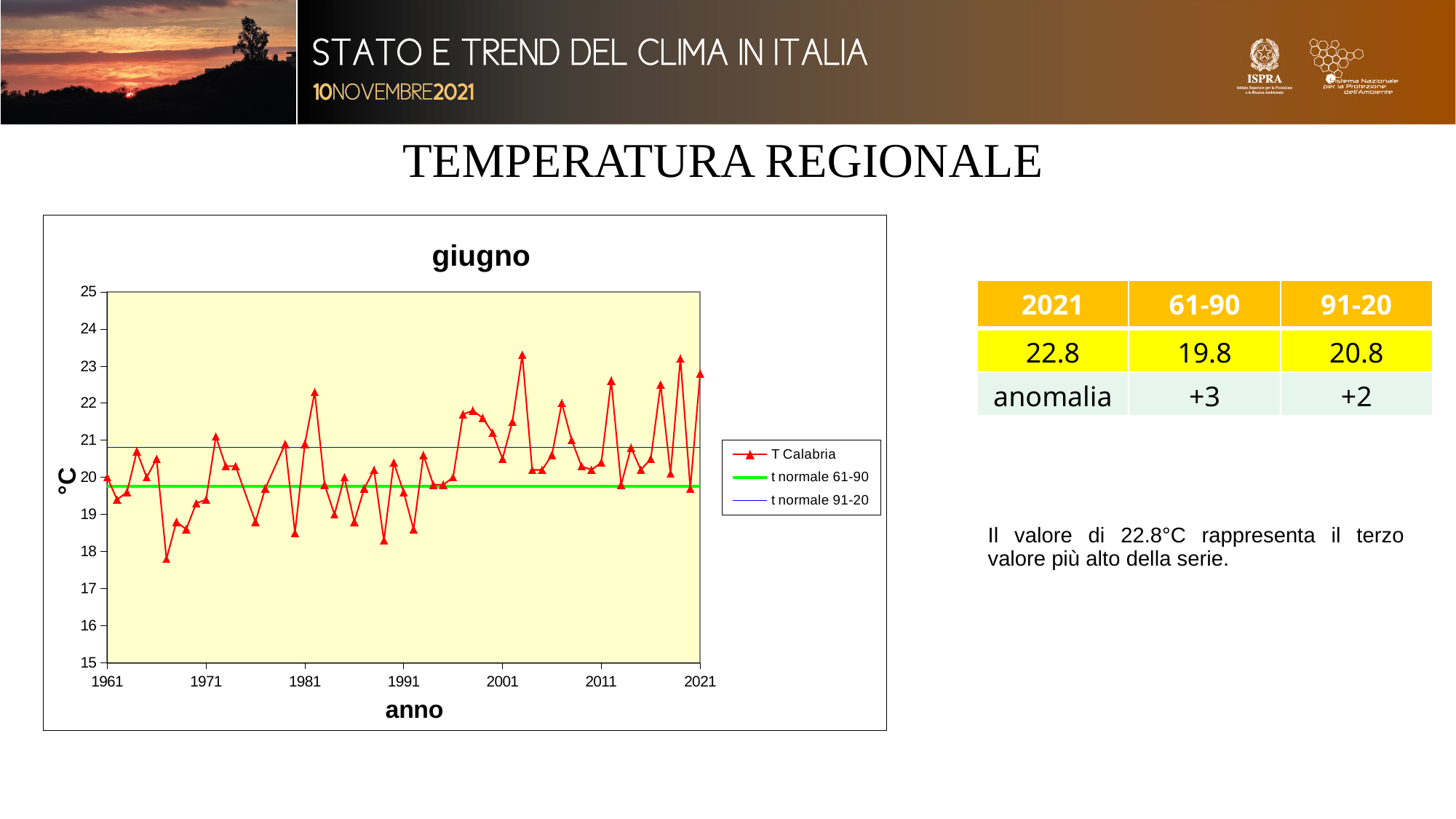
What is the title of the chart? giugno Do the T Calabria values generally rise or fall from 1961 to 2021? rise What kind of chart is shown on the slide? line chart What is the T Calabria value for 2021? 22.8 Is the T Calabria value for 1968 greater or less than 19? less At what value is the 't normale 91-20' line drawn? 20.8 What is the difference between the 2021 value and the 61-90 normal? 3 Is the T Calabria value for 1981 greater or less than 19? greater Is the T Calabria value for 2003 greater or less than 22? greater What is the label of the x axis of the chart? anno How many series does the chart legend list? 3 At what value is the 't normale 61-90' line drawn? 19.8